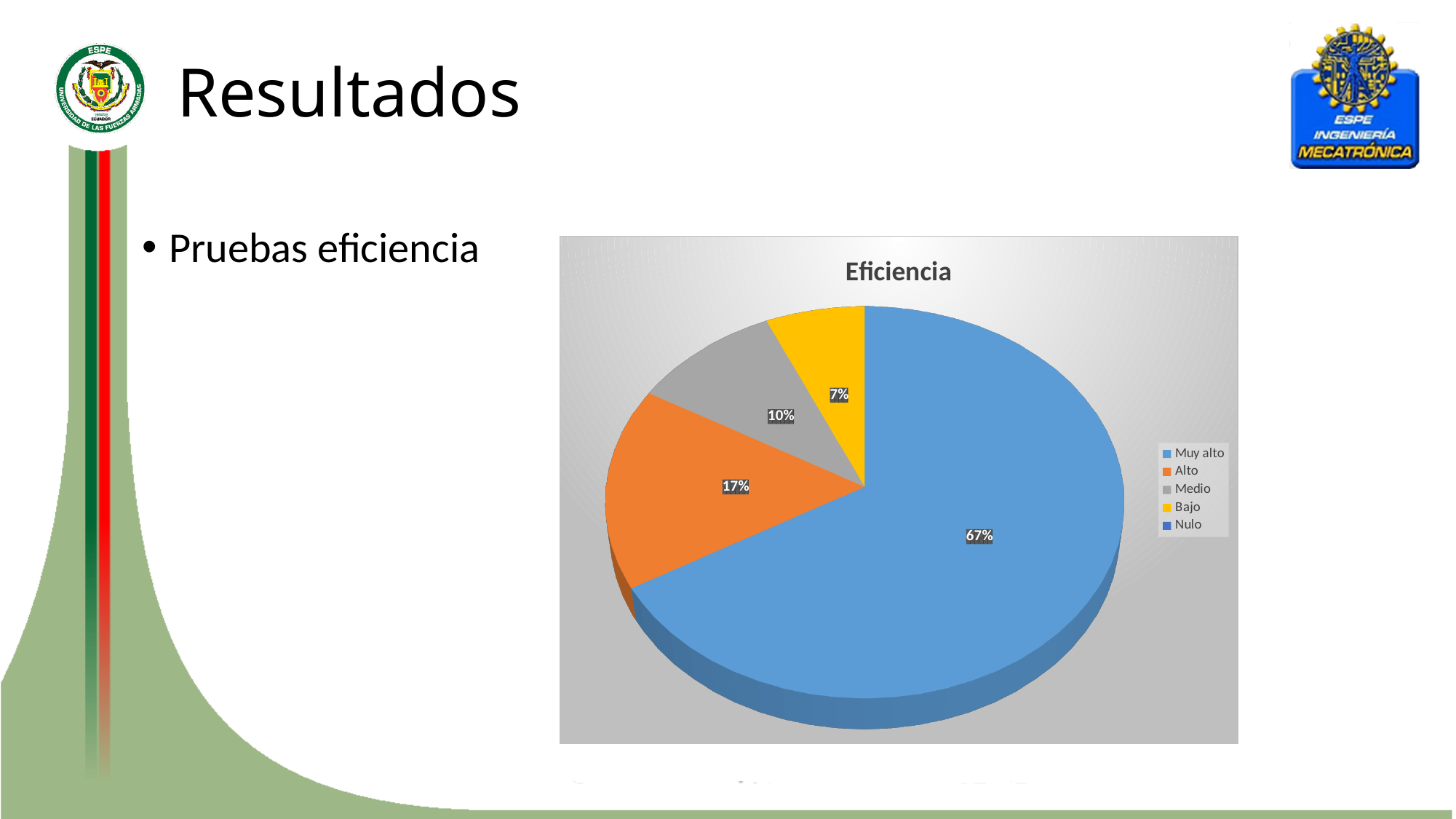
What colour is the Bajo slice? yellow How many categories does the legend list? 5 Which slice is larger, Alto or Medio? Alto Which category has the smallest visible slice of the pie? Bajo What is the value shown for the Medio slice? 10% What is the value shown for the Alto slice? 17% What is the title of the chart? Eficiencia What type of chart is shown on the slide? pie chart What is the difference in percentage points between the Muy alto and Alto slices? 50 percentage points What percentage of the pie does the Muy alto slice represent? 67% What is the value shown for the Bajo slice? 7% Which category has the largest slice of the pie? Muy alto